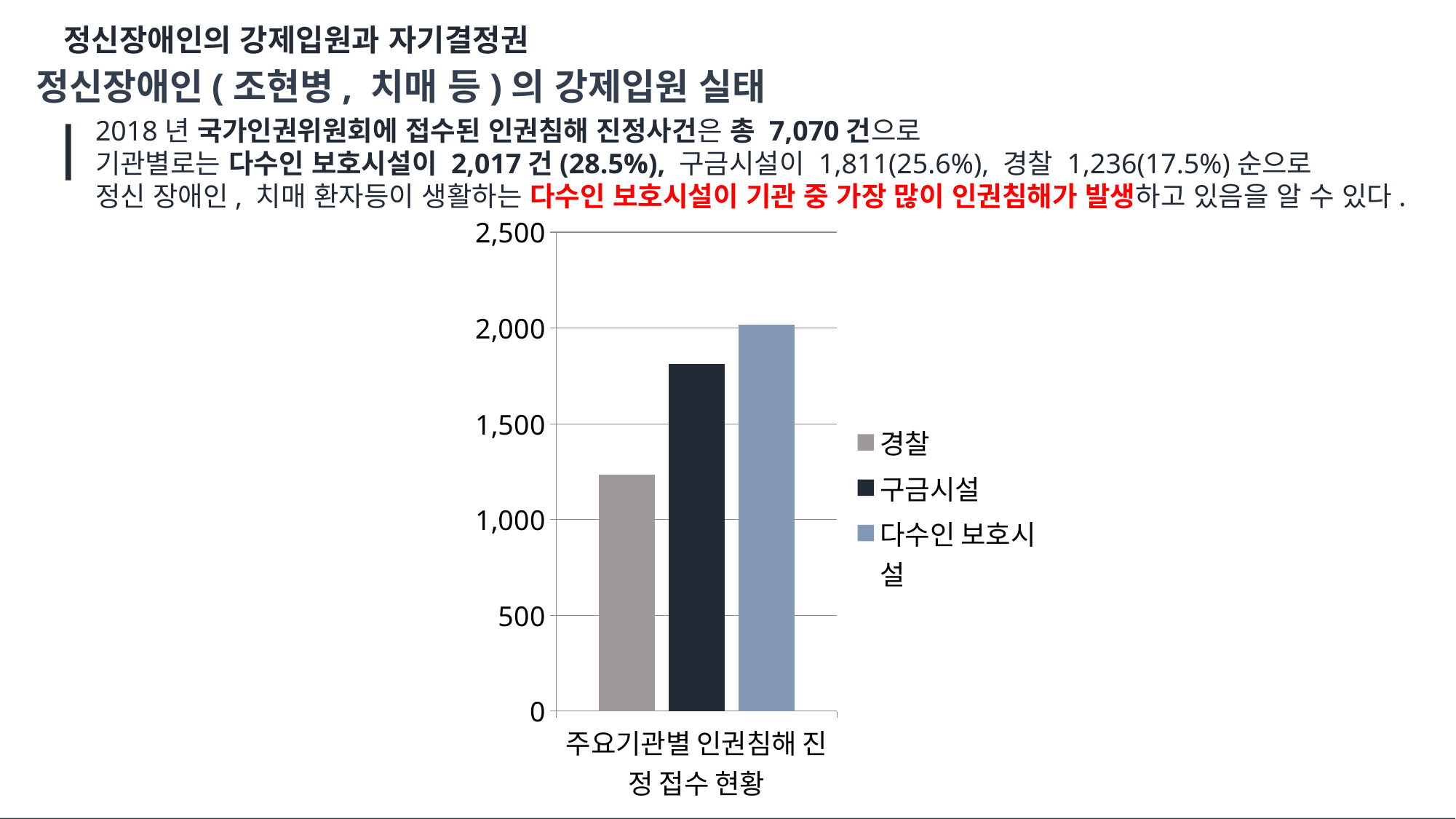
Which series has the lowest bar? 경찰 Is the value for 다수인 보호시설 greater or less than 1,500? greater Is the value for 구금시설 greater or less than 2,000? less Which series has the highest bar? 다수인 보호시설 Is the value for 경찰 greater or less than 1,000? greater What kind of chart is shown on the slide? bar chart How many bars are plotted in the chart? 3 What is the category label shown under the bars on the x axis? 주요기관별 인권침해 진정 접수 현황 Which is larger, the bar for 다수인 보호시설 or the bar for 구금시설? 다수인 보호시설 Which is larger, the bar for 구금시설 or the bar for 경찰? 구금시설 How many series does the legend list? 3